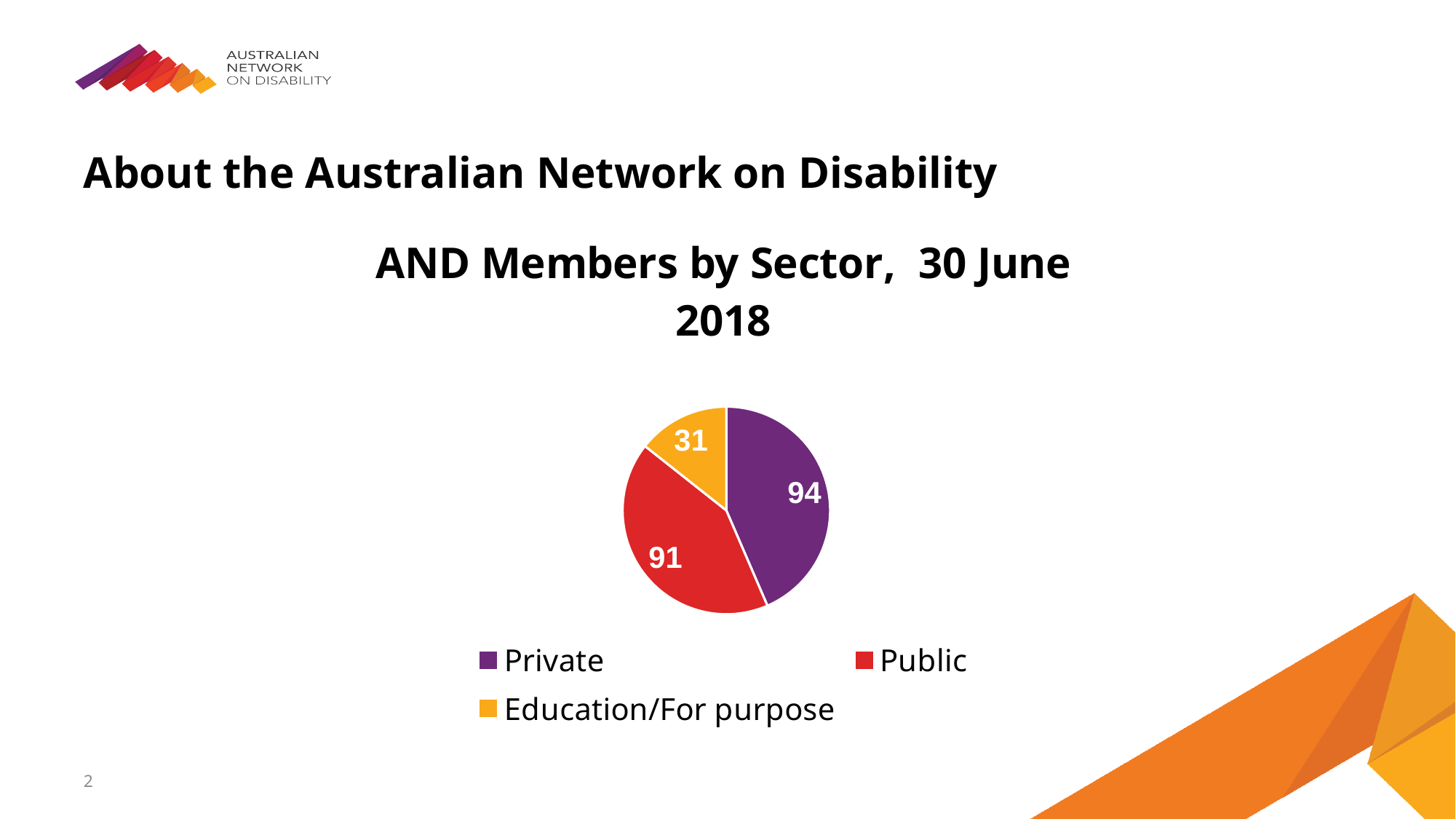
Which sector has the most members? Private How many members are in the Private sector? 94 What is the difference between the Public and Education/For purpose member counts? 60 What is the difference between the Private and Public member counts? 3 How many sectors are shown in the pie chart? 3 What kind of chart is shown on the slide? pie chart What colour is the Public slice? red How many members are in the Public sector? 91 Which sector has the fewest members? Education/For purpose What is the title of the chart? AND Members by Sector, 30 June 2018 Which has more members, Public or Education/For purpose? Public How many members are in the Education/For purpose sector? 31